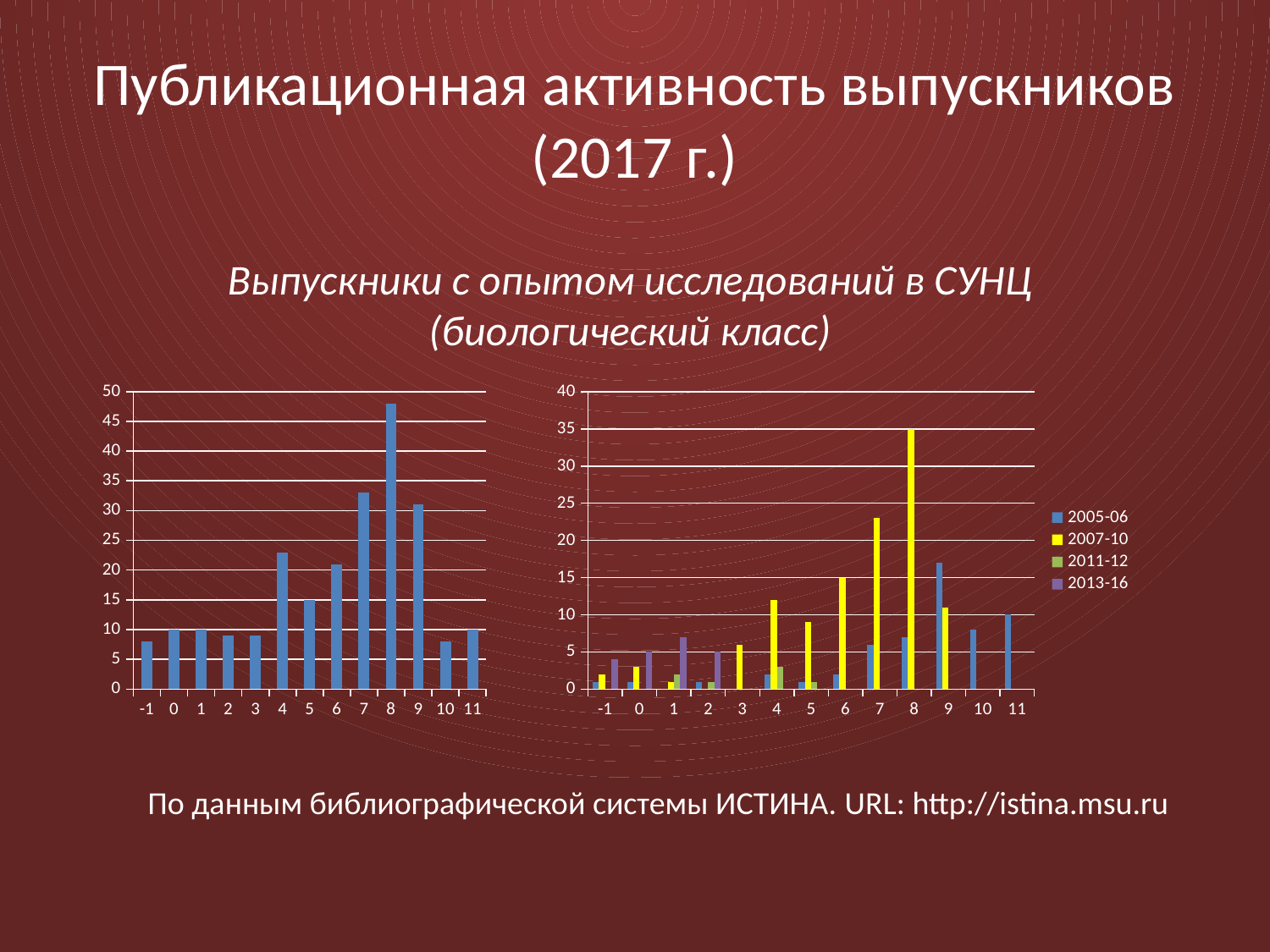
In the right chart, is the 2007-10 value for category 7 greater or less than 20? greater In the left chart, which is larger, the value for category 7 or the value for category 9? 7 How many categories are shown on the x axis of the left chart? 13 How many series does the legend of the right chart list? 4 In the right chart, which colour represents the 2007-10 series? yellow What kind of chart is the chart on the left? bar chart In the left chart, is the value for category 8 greater or less than 45? greater In the right chart, which series has the tallest bar overall? 2007-10 In the left chart, is the value for category 4 greater or less than 20? greater In the left chart, which category has the highest bar? 8